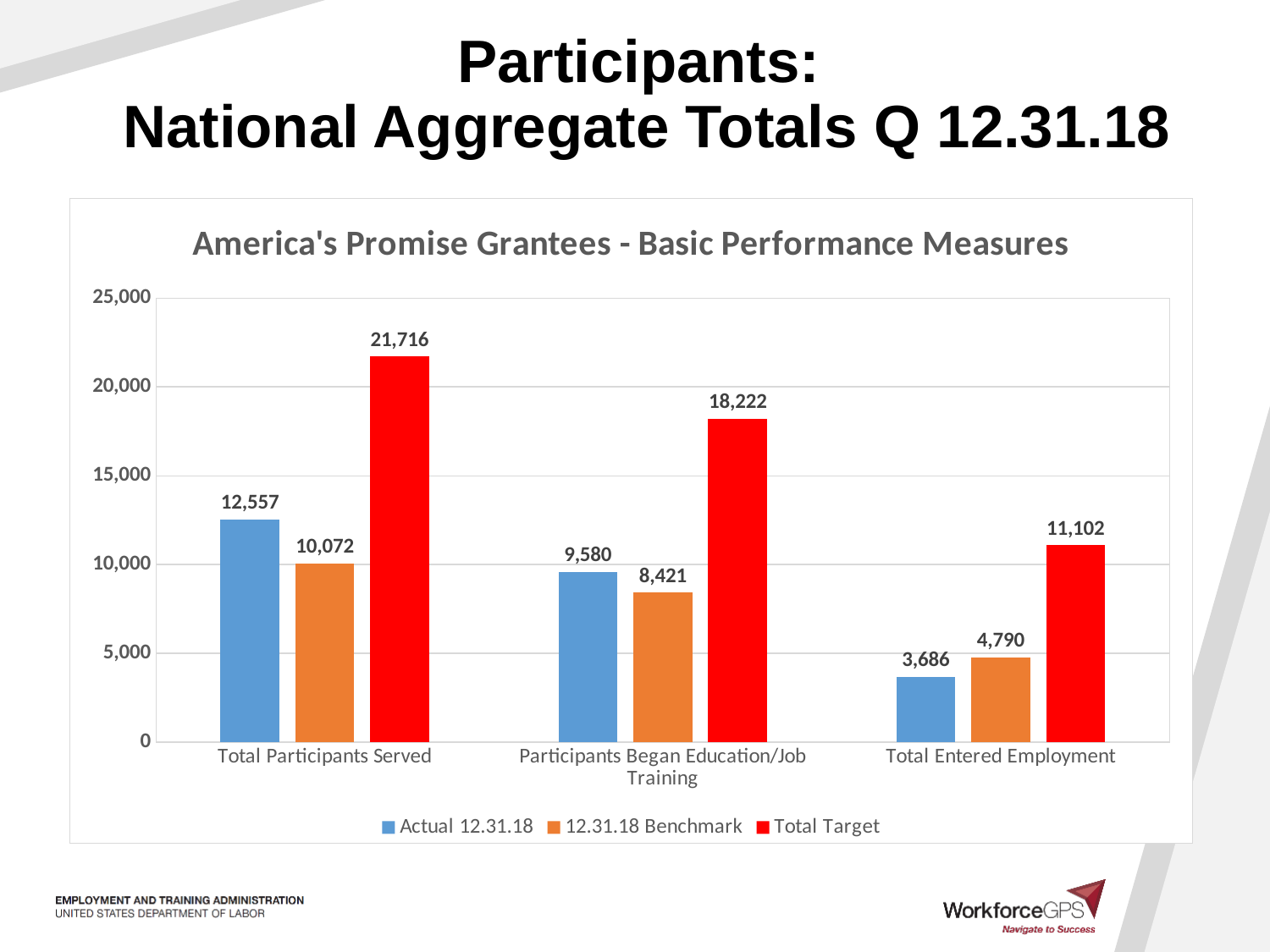
Which category has the lowest Actual 12.31.18 value? Total Entered Employment How many series does the legend list? 3 How many categories are shown on the x axis? 3 Which category has the highest Total Target value? Total Participants Served What is the title of the chart? America's Promise Grantees - Basic Performance Measures What is the 12.31.18 Benchmark value for Total Entered Employment? 4,790 Is the Actual 12.31.18 value for Participants Began Education/Job Training greater or less than 10,000? less What is the difference between the Total Target and the Actual 12.31.18 value for Total Participants Served? 9,159 For Total Entered Employment, which is larger: the Actual 12.31.18 value or the 12.31.18 Benchmark? 12.31.18 Benchmark What is the Actual 12.31.18 value for Total Participants Served? 12,557 What is the Total Target value for Participants Began Education/Job Training? 18,222 What kind of chart is shown on the slide? bar chart